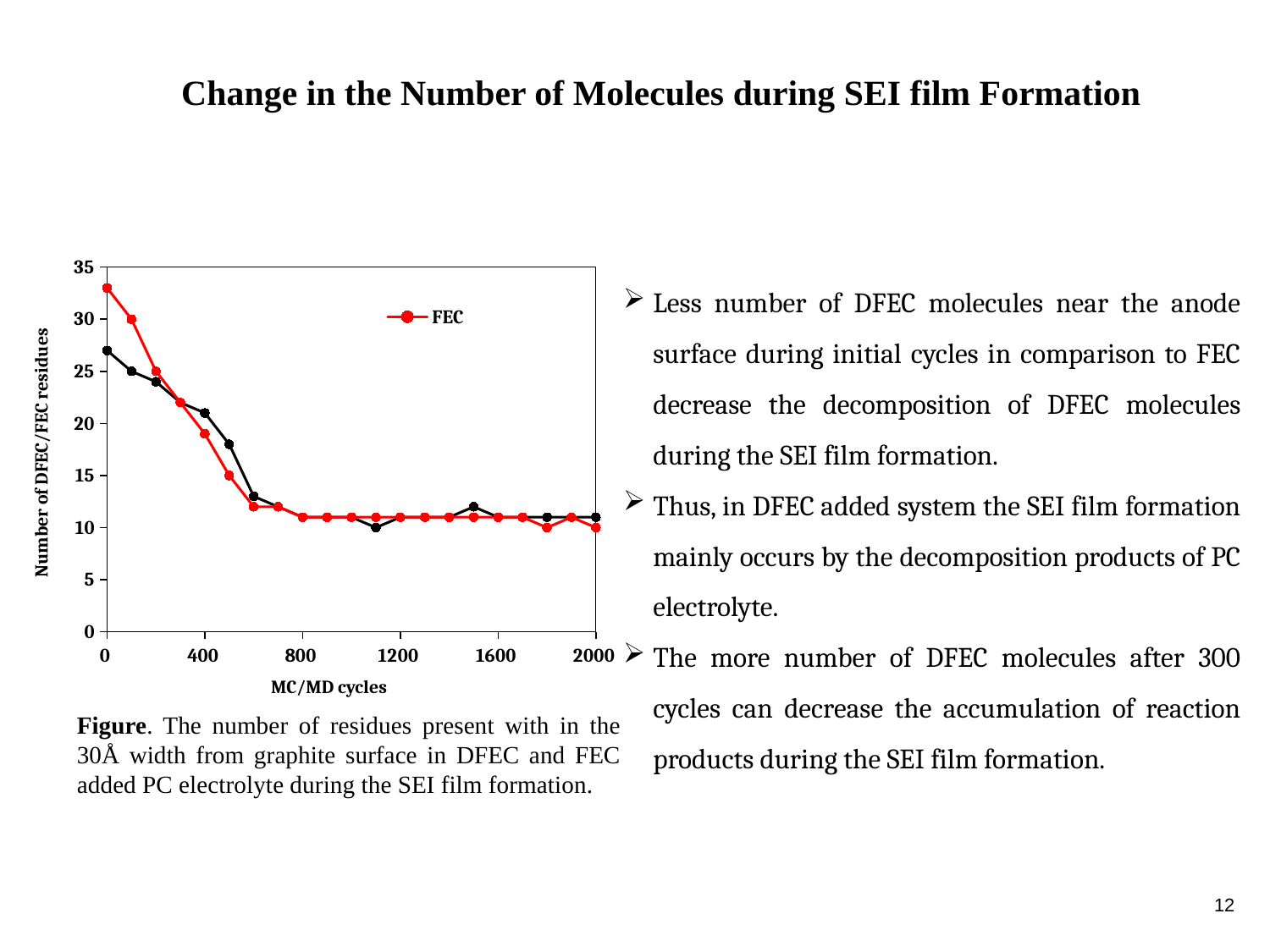
What kind of chart is shown on the slide? line chart At 0 MC/MD cycles, which series has the higher value, FEC or the black (unlabelled) series? FEC At 400 MC/MD cycles, which series has the higher value, FEC or the black (unlabelled) series? the black (unlabelled) series Do the FEC values rise or fall between 0 and 800 MC/MD cycles? fall Is the FEC value at 1000 MC/MD cycles greater or less than 15? less What is the label of the x axis of the chart? MC/MD cycles Is the FEC value at 0 MC/MD cycles greater or less than 30? greater At which number of MC/MD cycles is the FEC value highest? 0 Is the FEC value at 400 MC/MD cycles greater or less than 20? less How many series does the chart's legend list? 1 What is the name of the series shown in the chart's legend? FEC